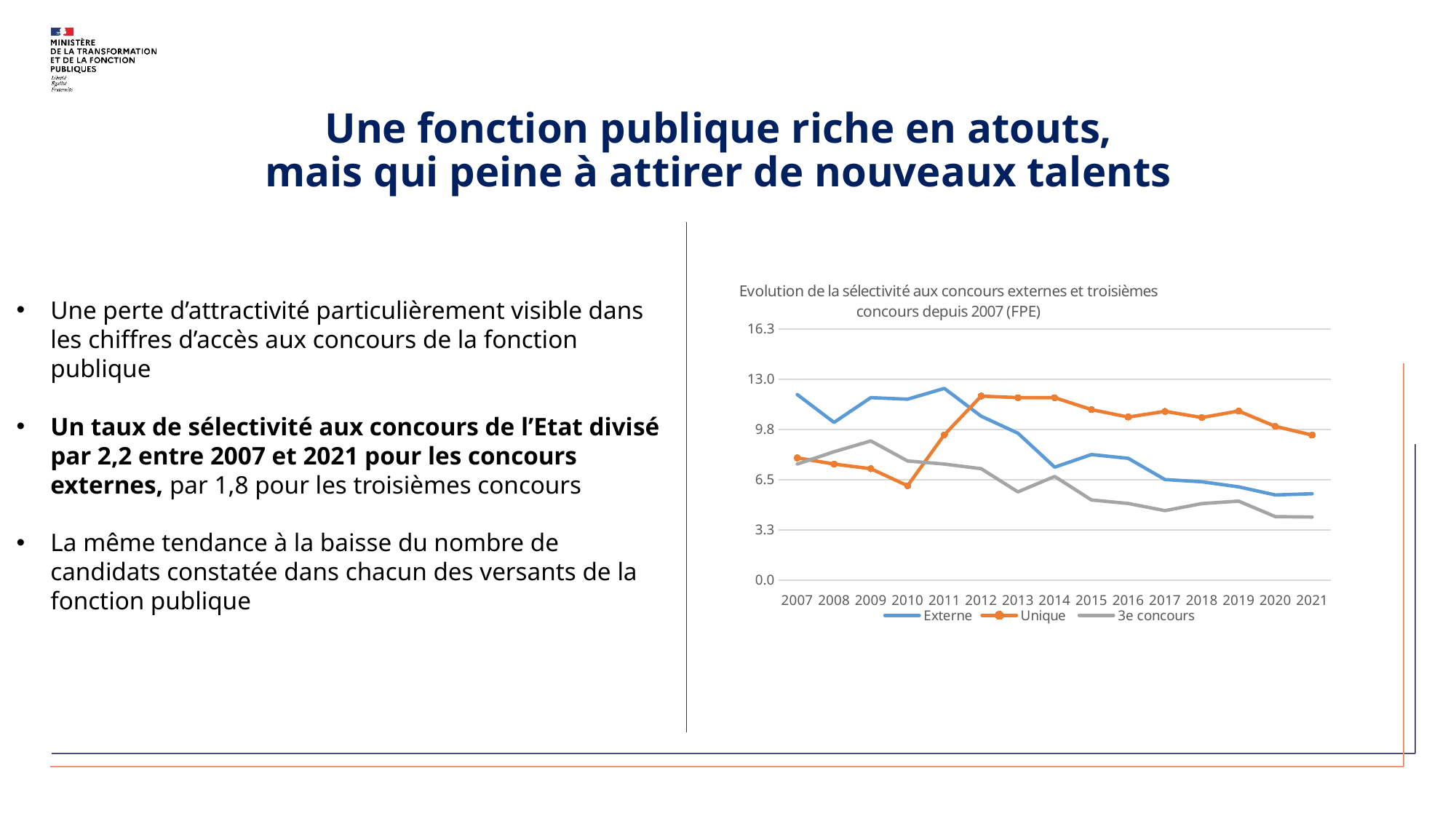
In 2007, which series has the higher value, Externe or Unique? Externe How many years are plotted along the x axis of the chart? 15 What kind of chart is shown on the slide? line chart Is the value for 3e concours in 2021 greater or less than 6.5? less Is the value for Externe in 2007 greater or less than 9.8? greater In which year does the Unique series reach its lowest value? 2010 Is the value for Unique in 2012 greater or less than 9.8? greater In 2021, which series has the higher value, Externe or Unique? Unique How many series does the chart legend list? 3 Which series does the orange line represent? Unique Does the Externe series rise or fall overall from 2007 to 2021? fall